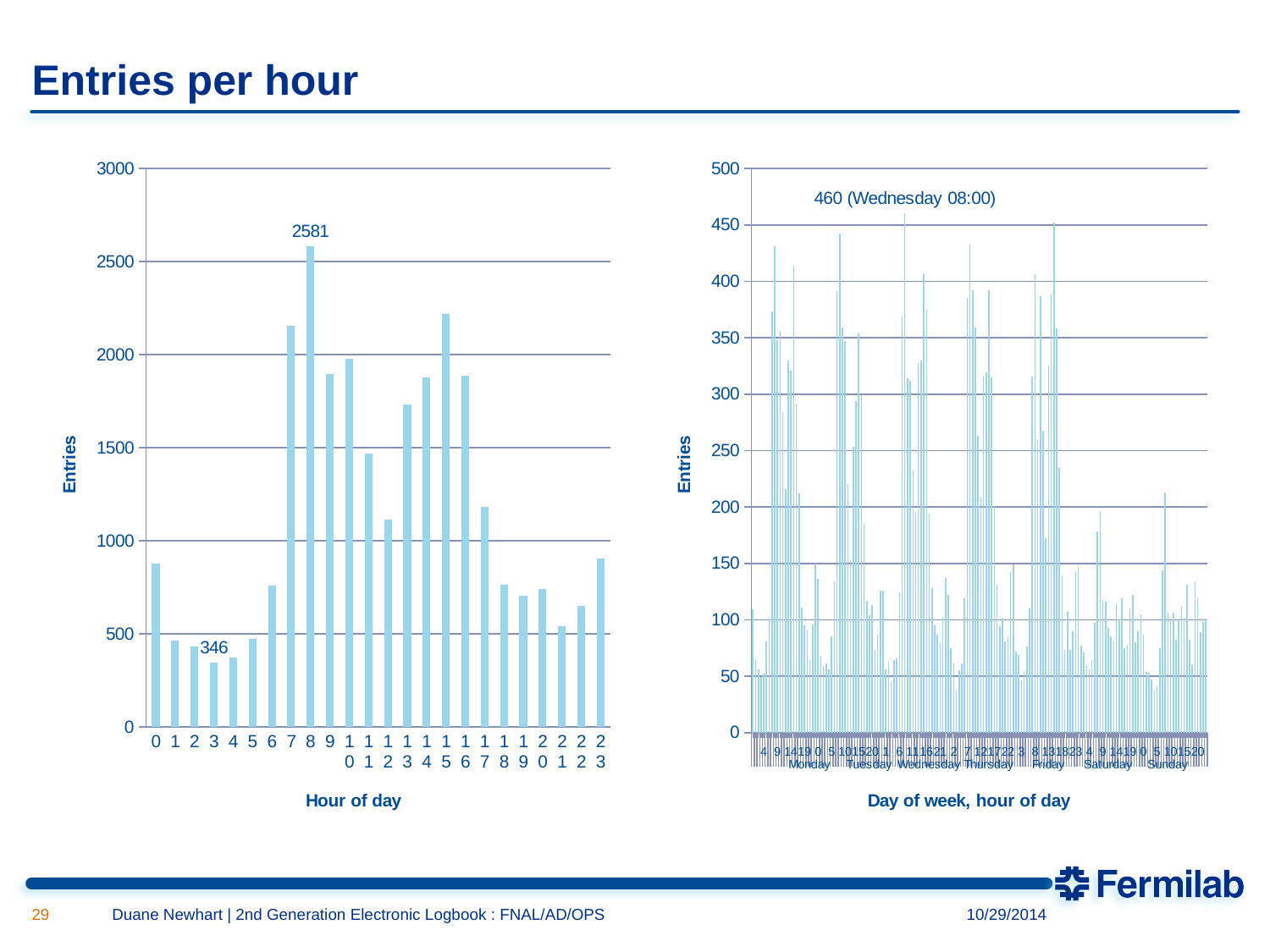
In the right chart (Day of week, hour of day), what is the highest value and when does it occur? 460 (Wednesday 08:00) In the left chart (Hour of day), how many hours (bars) are plotted? 24 In the left chart (Hour of day), what is the difference between the highest value (hour 8) and the lowest value (hour 3)? 2235 In the left chart (Hour of day), is the value for hour 15 greater or less than 2000? greater In the left chart (Hour of day), which hour has the lowest number of entries? 3 In the left chart (Hour of day), what is the value for hour 3? 346 What is the title of the y axis on the left chart? Entries In the left chart (Hour of day), which has more entries, hour 8 or hour 15? hour 8 In the left chart (Hour of day), which hour has the highest number of entries? 8 In the left chart (Hour of day), is the value for hour 0 greater or less than 1000? less What kind of chart is the left chart (Hour of day)? bar chart In the left chart (Hour of day), what is the value for hour 8? 2581